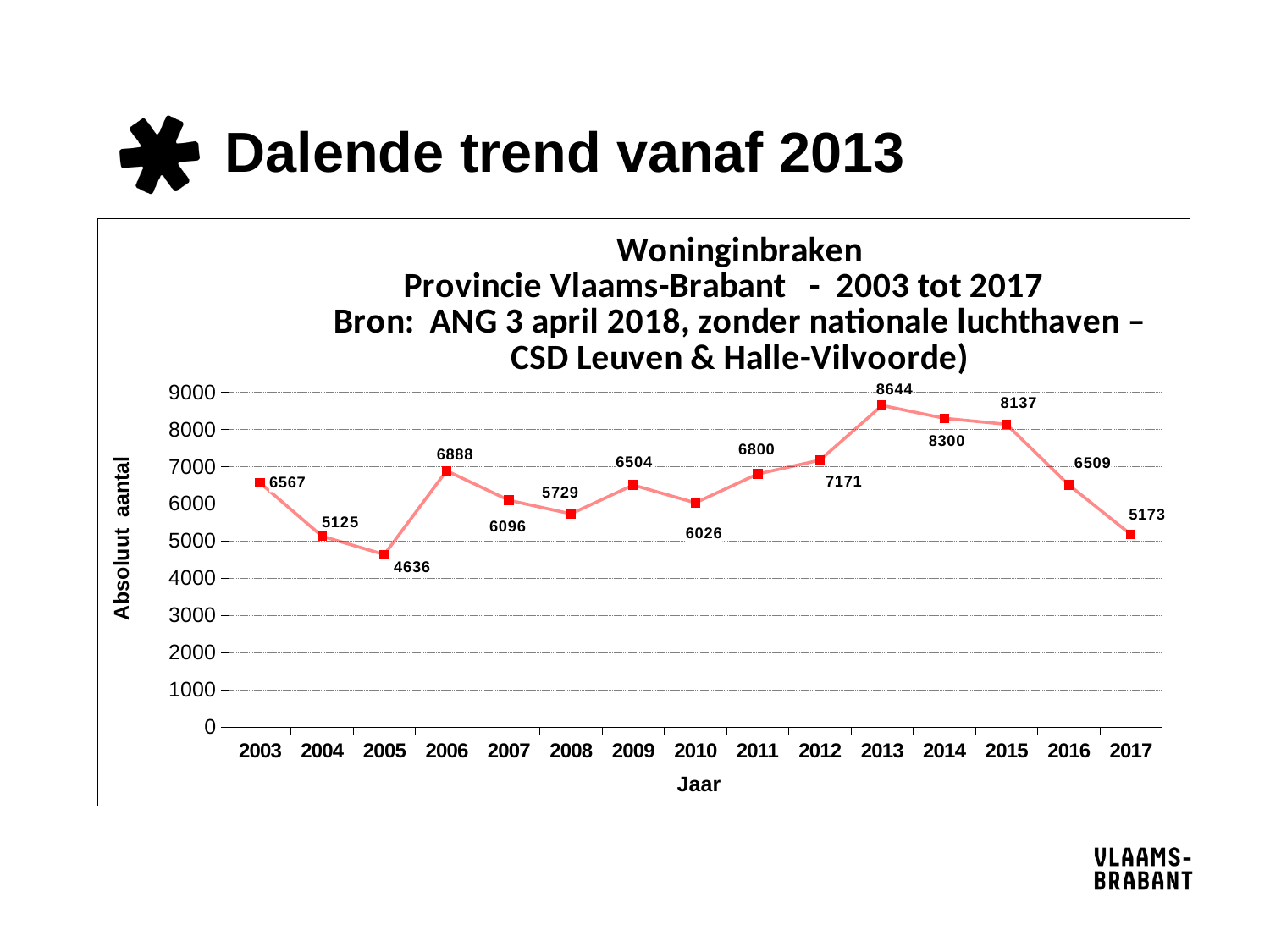
What is the value for 2017? 5173 How many years are plotted on the x axis? 15 What is the label of the y axis? Absoluut aantal What is the value for 2005? 4636 Is the value for 2014 greater or less than 8000? greater Do the values rise or fall from 2013 to 2017? fall What is the value for 2013? 8644 Which year has the lowest value? 2005 Which is larger, the value for 2006 or the value for 2011? 2006 Which year has the highest value? 2013 What is the difference between the values for 2013 and 2017? 3471 What kind of chart is shown? line chart